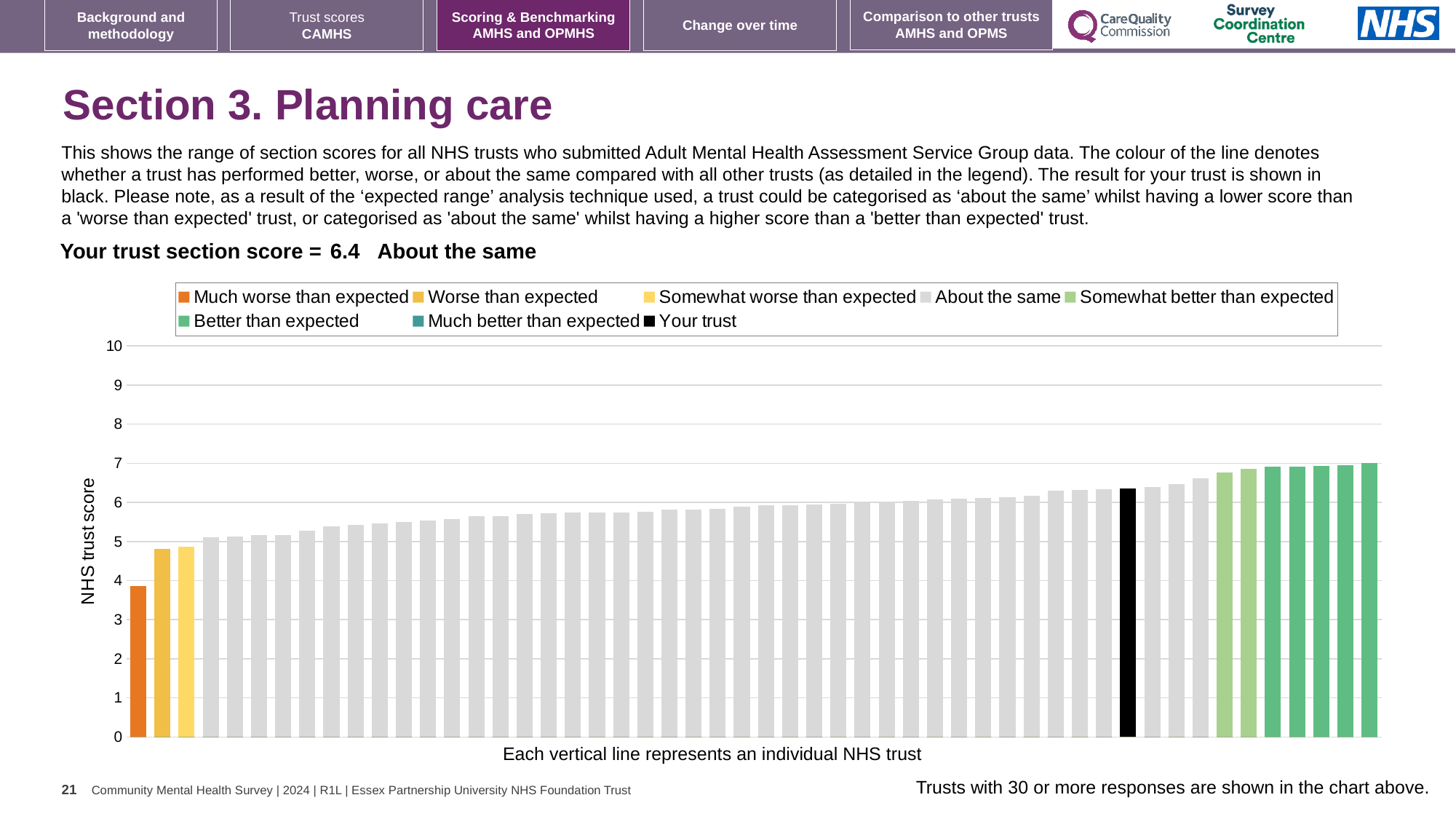
Which performance category is your trust placed in for this section? About the same Is the value of the 'Much worse than expected' bar greater or less than 5? less What is the section score for your trust shown on the slide? 6.4 How many bars are coloured as 'Worse than expected'? 1 Which legend category does the lowest bar in the chart belong to? Much worse than expected Is the value of the 'Your trust' bar greater or less than 6? greater What kind of chart is shown on the slide? bar chart Is the tallest bar in the chart greater or less than 8? less Do the bar values rise or fall from left to right along the x axis? rise How many bars are coloured as 'Much worse than expected'? 1 What is the label on the vertical axis of the chart? NHS trust score How many entries does the chart legend list? 8